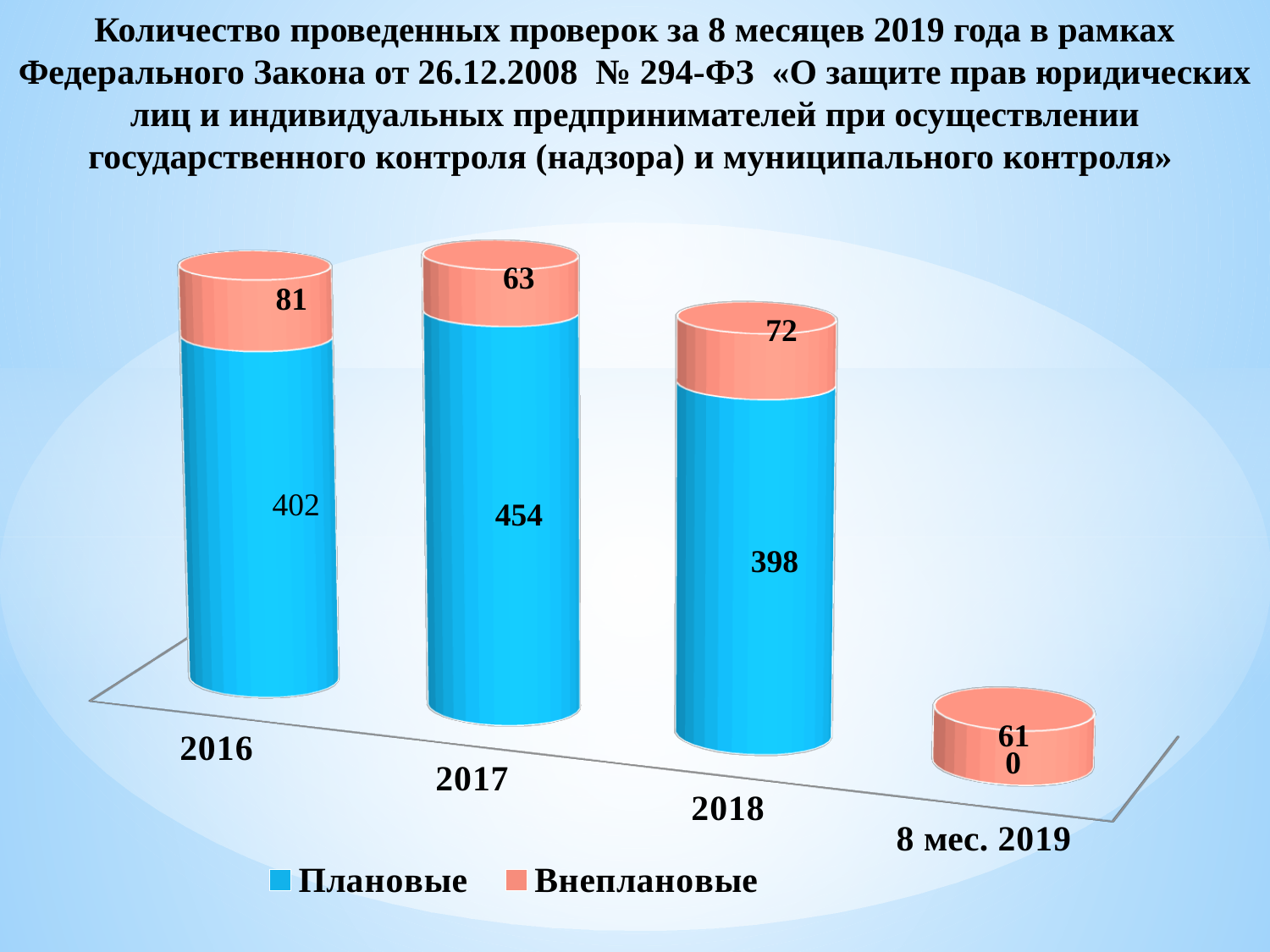
What is the value for Внеплановые in 2016? 81 What is the value for Внеплановые in 2018? 72 What is the difference between the Плановые values for 2017 and 2018? 56 How many categories are shown on the x axis? 4 Which is larger: Внеплановые in 2016 or Внеплановые in 2018? 2016 What kind of chart is shown on the slide? Stacked bar chart What is the total of the stacked bar for 2016? 483 Which year has the highest value for Плановые? 2017 How many series does the legend list? 2 What is the value for Плановые for 8 мес. 2019? 0 Which category has the lowest value for Внеплановые? 8 мес. 2019 What is the value for Плановые in 2017? 454